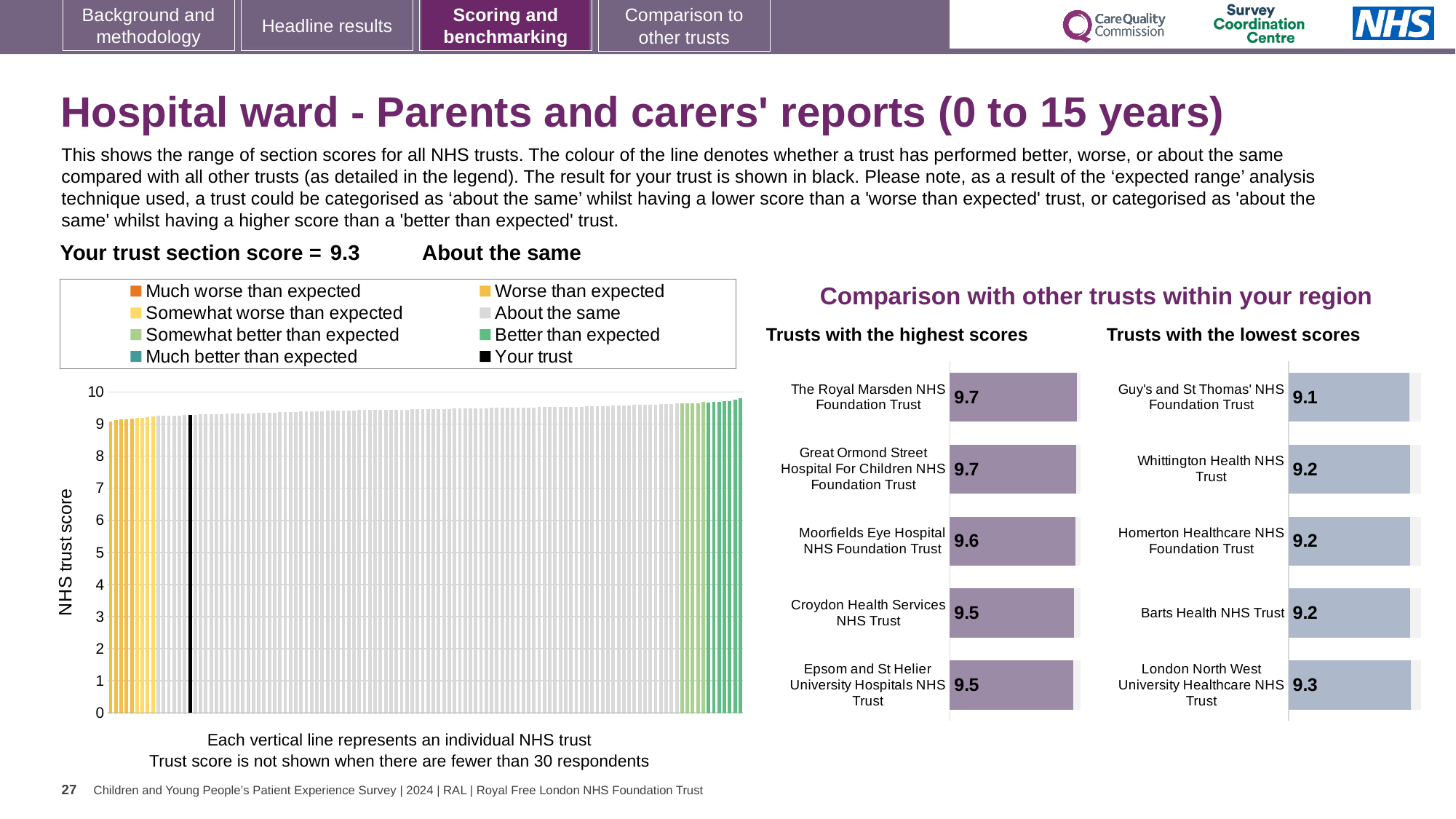
In the 'Trusts with the lowest scores' chart, which trust has the highest score? London North West University Healthcare NHS Trust In the 'NHS trust score' chart on the left, is the value of the black bar for your trust greater or less than 5? greater In the 'Trusts with the highest scores' chart, which has the higher score: Croydon Health Services NHS Trust or Moorfields Eye Hospital NHS Foundation Trust? Moorfields Eye Hospital NHS Foundation Trust How many trusts are shown in the 'Trusts with the highest scores' chart? 5 In the 'Trusts with the lowest scores' chart, what is the score for Guy's and St Thomas' NHS Foundation Trust? 9.1 In the 'Trusts with the highest scores' chart, what is the score for The Royal Marsden NHS Foundation Trust? 9.7 In the 'Trusts with the lowest scores' chart, what is the score for London North West University Healthcare NHS Trust? 9.3 What is the section score for your trust shown on the slide? 9.3 In the 'Trusts with the highest scores' chart, what is the score for Moorfields Eye Hospital NHS Foundation Trust? 9.6 What kind of chart is the 'NHS trust score' chart on the left of the slide? bar chart In the 'Trusts with the highest scores' chart, what is the difference between the scores of The Royal Marsden NHS Foundation Trust and Epsom and St Helier University Hospitals NHS Trust? 0.2 In the 'Trusts with the lowest scores' chart, which trust has the lowest score? Guy's and St Thomas' NHS Foundation Trust